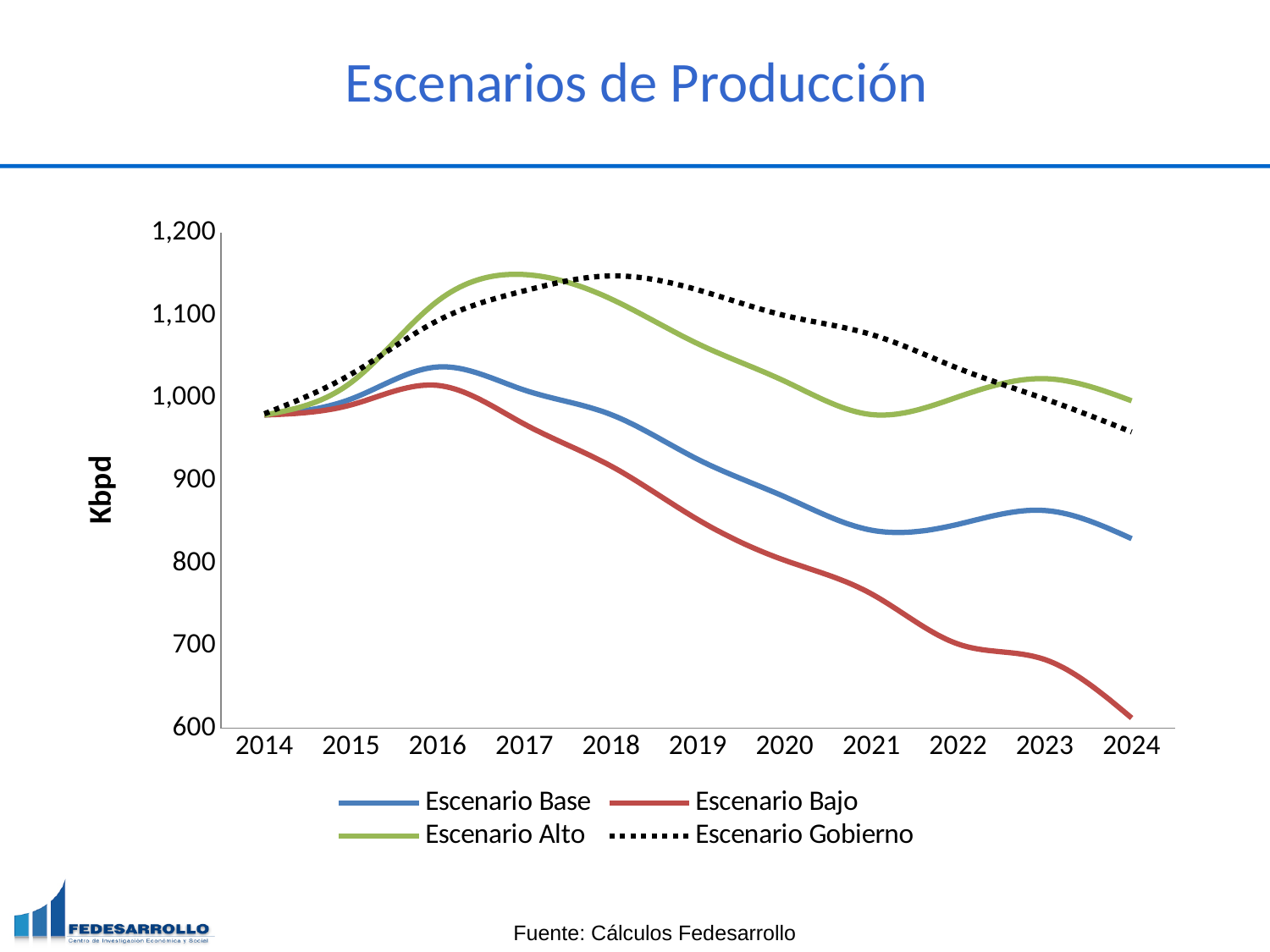
What is the title of the chart? Escenarios de Producción How many years are shown along the x axis? 11 Does the Escenario Bajo line rise or fall from 2016 to 2024? fall Is the value for Escenario Gobierno in 2024 greater or less than 1,000? less Is the value for Escenario Base in 2024 greater or less than 900? less Is the value for Escenario Alto in 2017 greater or less than 1,100? greater In 2019, which is larger: Escenario Gobierno or Escenario Alto? Escenario Gobierno What kind of chart is shown on the slide? line chart What is the label on the y axis? Kbpd Which series has the lowest value in 2024? Escenario Bajo How many series does the legend list? 4